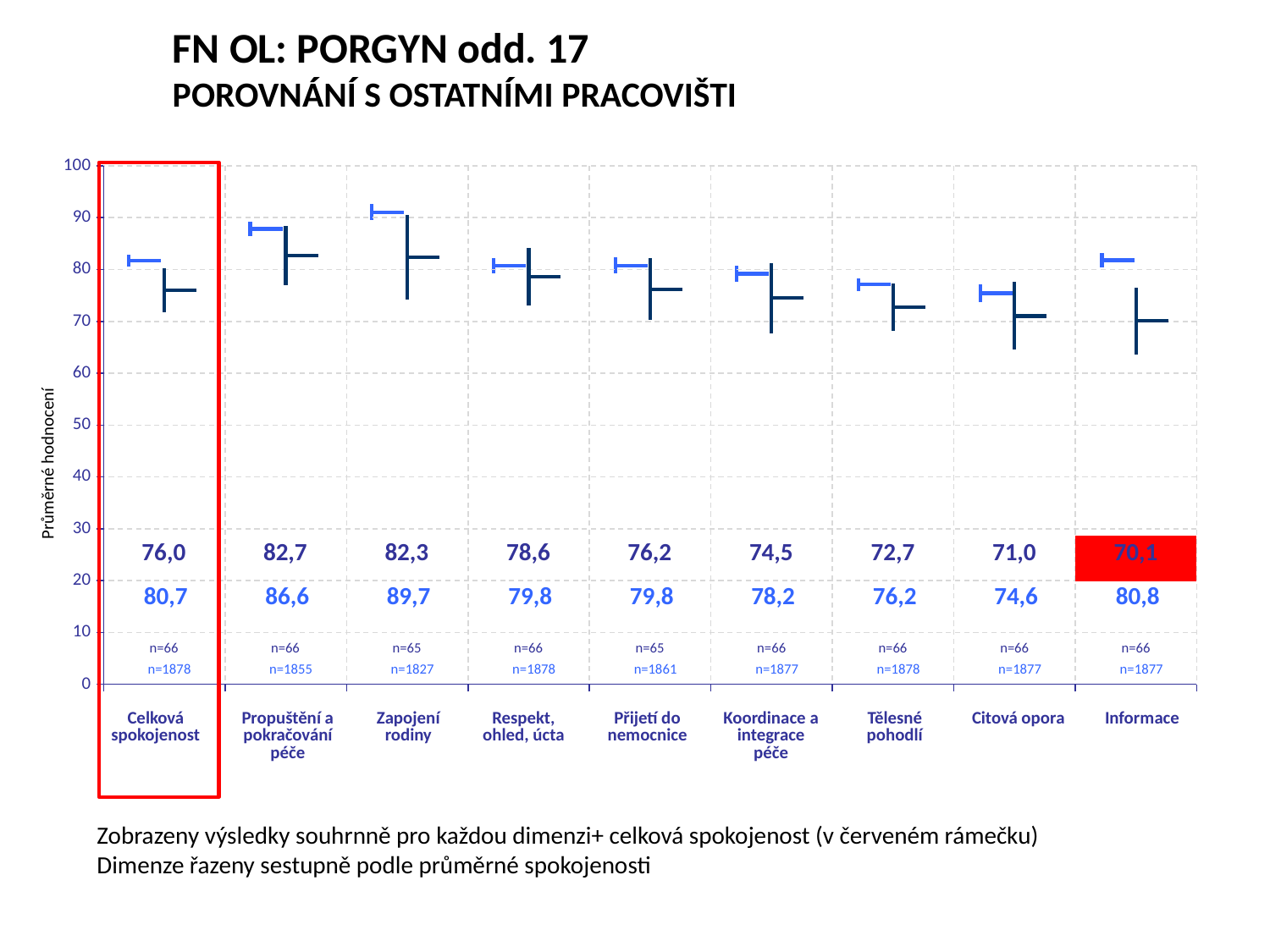
What is the n value printed in dark blue for Zapojení rodiny? n=65 How many categories are shown on the x axis? 9 What is the difference between the light blue and dark blue printed values for Informace? 10,7 Which category has the highest dark blue (upper) printed value? Propuštění a pokračování péče Which category has the lowest dark blue (upper) printed value? Informace What is the dark blue (upper) value printed for Celková spokojenost? 76,0 What is the dark blue value printed for Informace, shown in the red box? 70,1 Which is larger for Tělesné pohodlí: the dark blue value or the light blue value? the light blue value (76,2) What is the label of the y axis? Průměrné hodnocení Which category has the highest light blue (lower) printed value? Zapojení rodiny Do the dark blue printed values rise or fall from Propuštění a pokračování péče to Informace along the x axis? fall What is the light blue (lower) value printed for Zapojení rodiny? 89,7